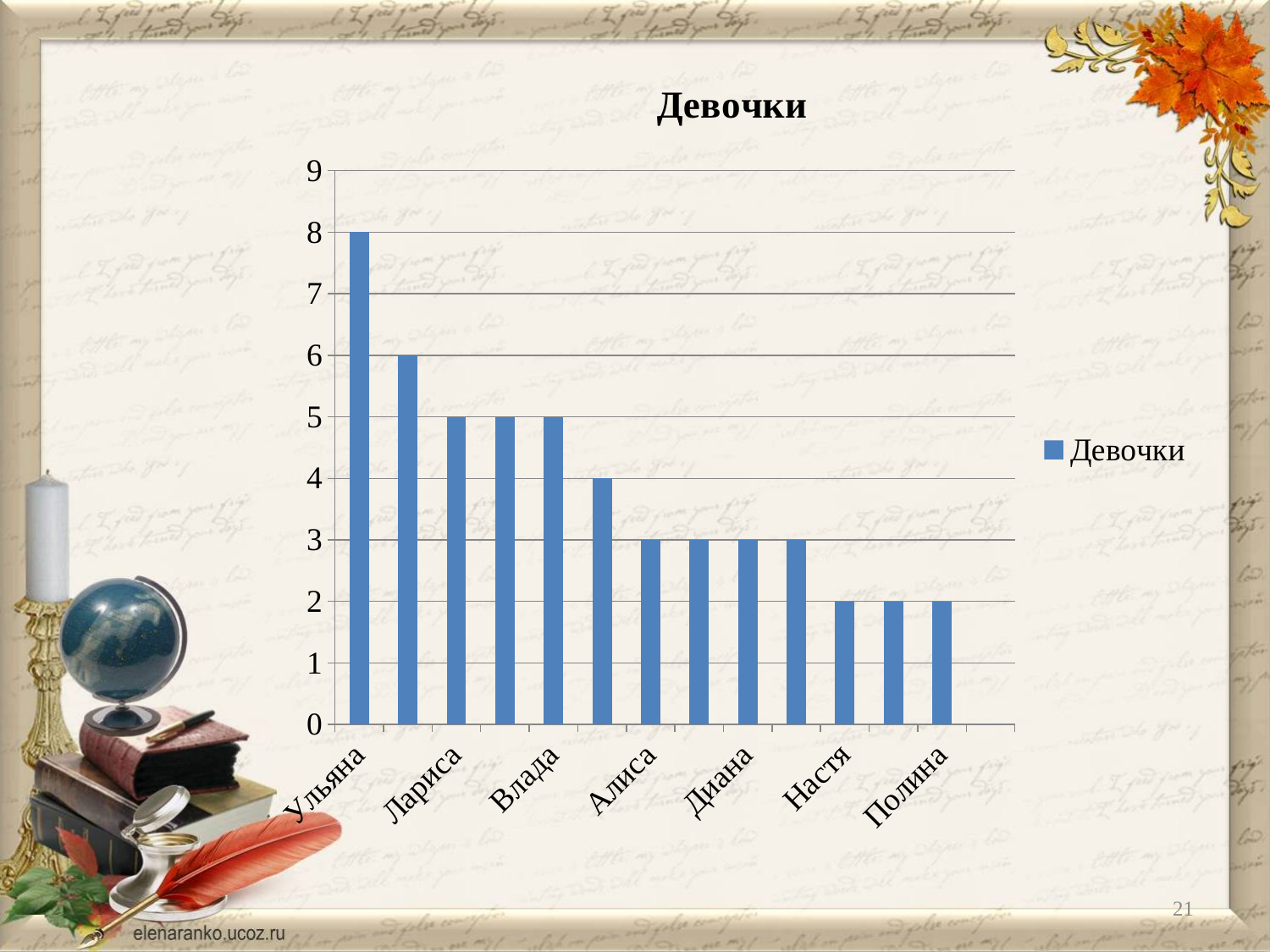
Which category has the highest value? Ульяна What is the value for Ульяна? 8 What is the title of the chart? Девочки How many series does the legend list? 1 How many bars are plotted in the chart? 13 Which is larger, the value for Влада or the value for Настя? Влада What is the value for Лариса? 5 What is the value for Алиса? 3 What is the difference between the values for Ульяна and Лариса? 3 What is the value for Полина? 2 Do the values generally rise or fall from left to right along the x axis? fall What kind of chart is shown on the slide? bar chart